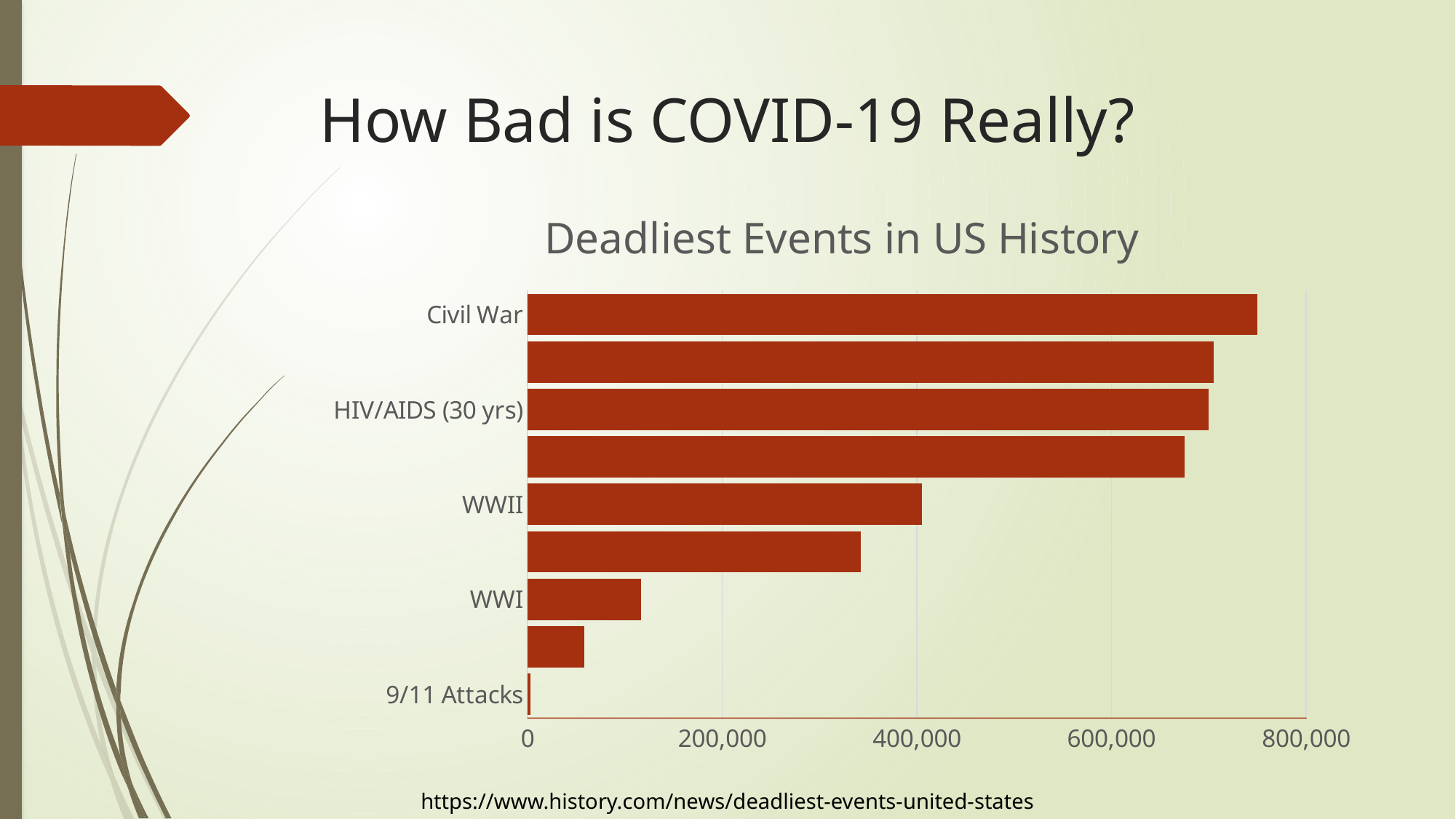
What is the highest value shown on the horizontal axis? 800,000 What kind of chart is shown on the slide? Bar chart Which labelled event has the shortest bar in the chart? 9/11 Attacks Is the value for Civil War greater or less than 600,000? greater What is the title of the chart? Deadliest Events in US History Which event has the longest bar in the chart? Civil War Is the value for HIV/AIDS (30 yrs) greater or less than 600,000? greater How many bars are plotted in the chart? 9 Which is larger, the value for WWI or the value for WWII? WWII Is the value for WWII greater or less than 600,000? less Which is larger, the value for Civil War or the value for HIV/AIDS (30 yrs)? Civil War